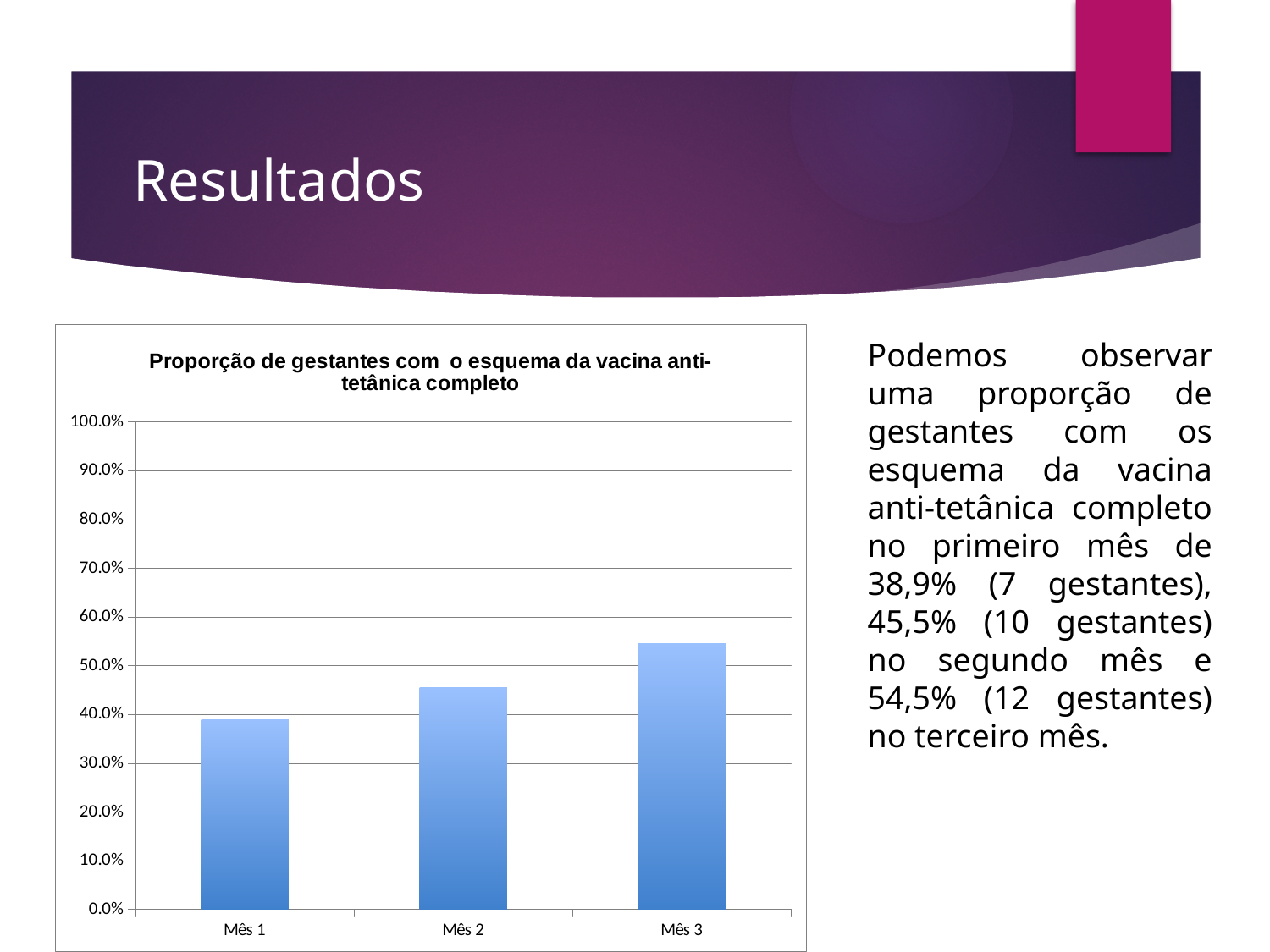
Is the value for Mês 3 greater or less than 60.0%? less What is the title of the chart? Proporção de gestantes com o esquema da vacina anti-tetânica completo What is the highest value shown on the y axis of the chart? 100.0% Is the value for Mês 3 greater or less than 50.0%? greater What kind of chart is shown on the slide? bar chart Do the values rise or fall from Mês 1 to Mês 3? rise Is the value for Mês 2 greater or less than 50.0%? less Which month has the lowest proportion in the chart? Mês 1 Which month has the highest proportion in the chart? Mês 3 How many categories are plotted on the x axis of the chart? 3 Which is larger, the value for Mês 1 or the value for Mês 2? Mês 2